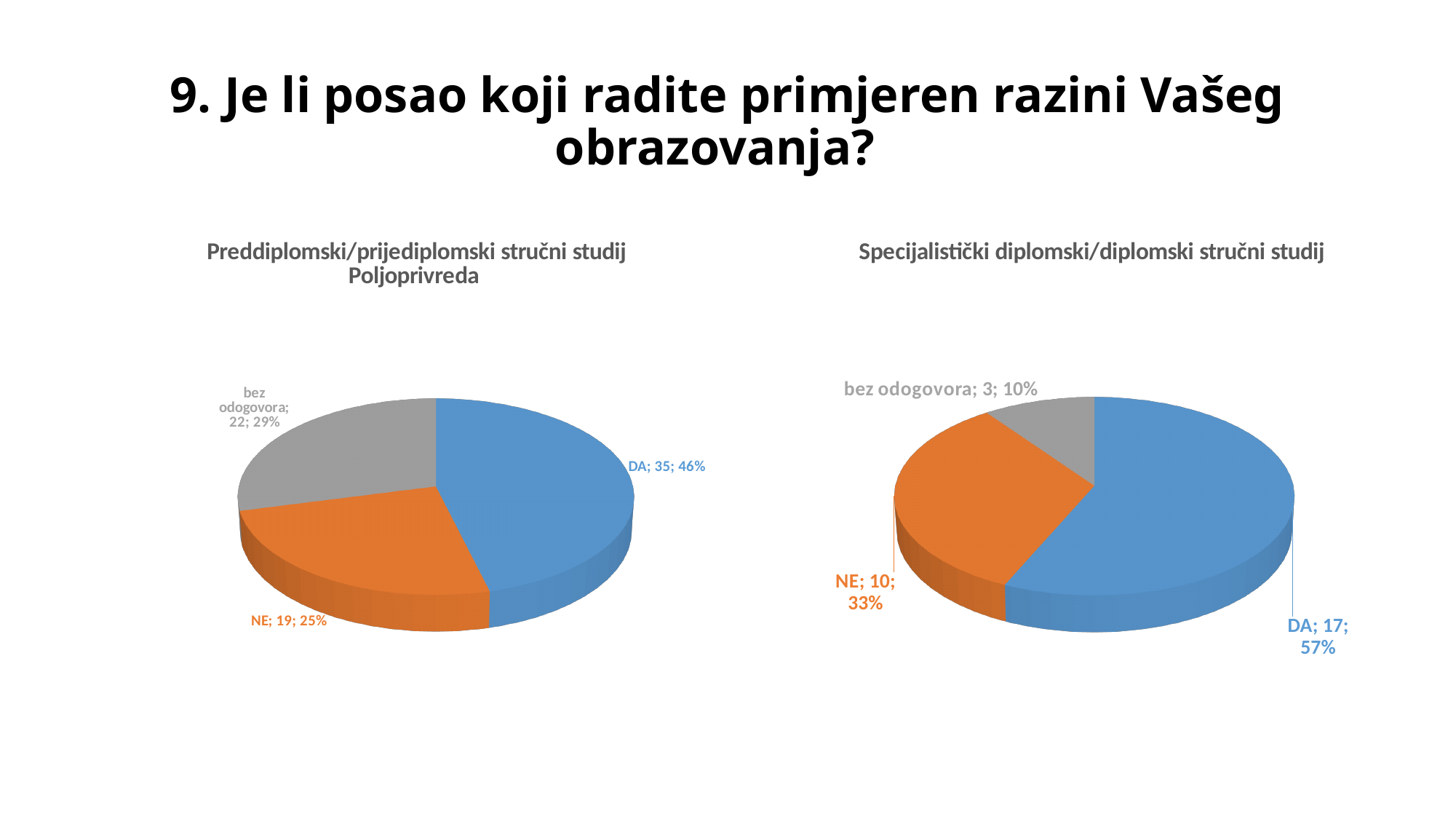
In the right chart (Specijalistički diplomski/diplomski stručni studij), which is larger, DA or NE? DA In the right chart (Specijalistički diplomski/diplomski stručni studij), what percentage share does DA have? 57% In the left chart (Preddiplomski/prijediplomski stručni studij Poljoprivreda), what is the difference between the DA count and the bez odogovora count? 13 What type of chart is used on the right side of the slide (Specijalistički diplomski/diplomski stručni studij)? Pie chart In the left chart (Preddiplomski/prijediplomski stručni studij Poljoprivreda), which category has the largest slice? DA In the left chart (Preddiplomski/prijediplomski stručni studij Poljoprivreda), how many respondents answered DA? 35 In the left chart (Preddiplomski/prijediplomski stručni studij Poljoprivreda), which category has the smallest slice? NE In the right chart (Specijalistički diplomski/diplomski stručni studij), what is the total number of respondents across all three categories? 30 In the left chart (Preddiplomski/prijediplomski stručni studij Poljoprivreda), how many categories are shown? 3 In the right chart (Specijalistički diplomski/diplomski stručni studij), which category has the smallest slice? bez odogovora In the right chart (Specijalistički diplomski/diplomski stručni studij), how many respondents answered NE? 10 In the left chart (Preddiplomski/prijediplomski stručni studij Poljoprivreda), what percentage share does NE have? 25%